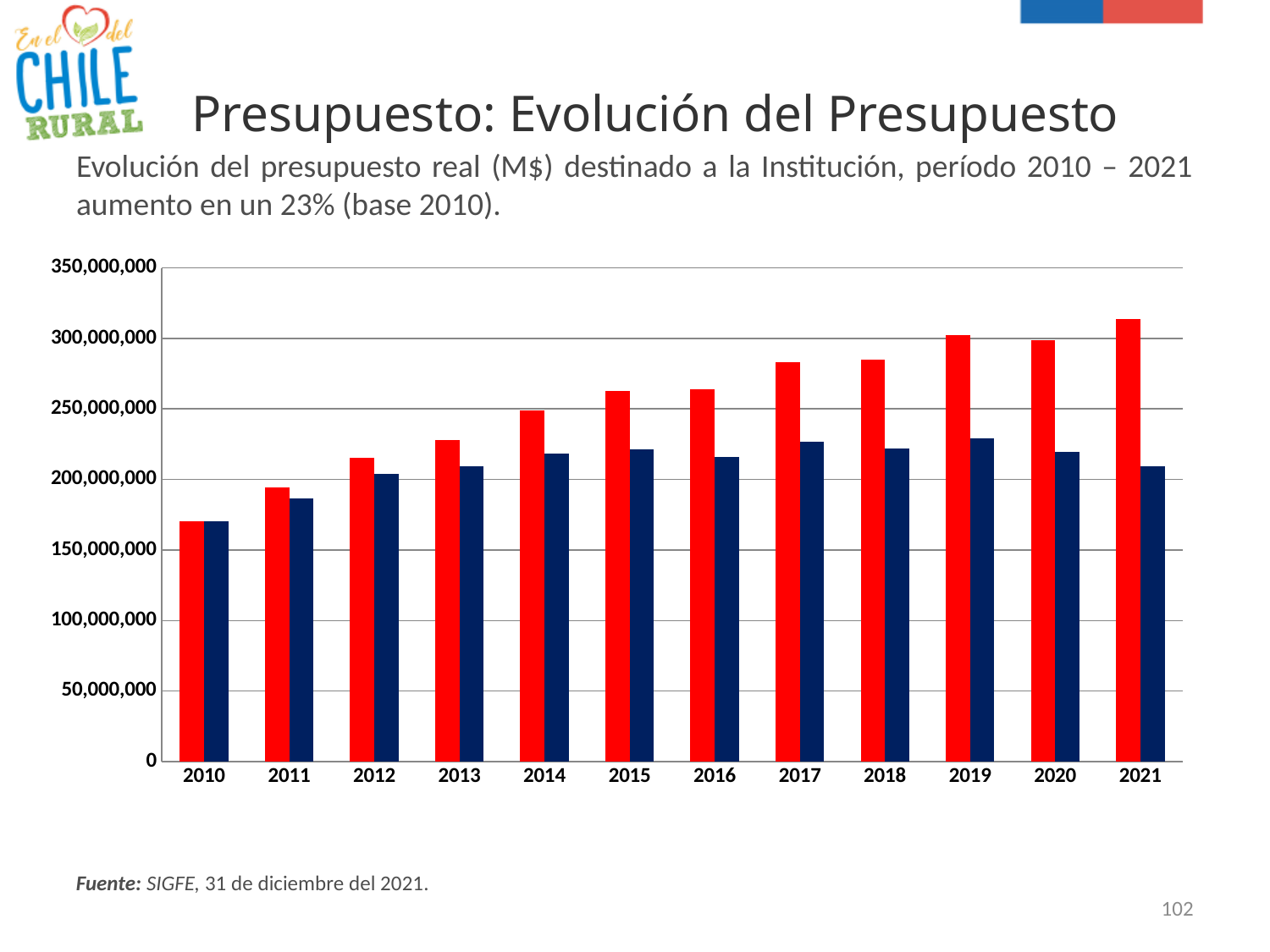
Which year has the tallest red bar? 2021 Is the value of the red bar for 2021 greater or less than 300,000,000? greater In 2021, which bar is taller, the red bar or the dark blue bar? the red bar Is the value of the red bar for 2010 greater or less than 200,000,000? less How many years are shown along the x axis of the chart? 12 Which year has the shortest dark blue bar? 2010 Which year has the shortest red bar? 2010 Do the red bars generally rise or fall from 2010 to 2021? rise What is the title of the slide containing the chart? Presupuesto: Evolución del Presupuesto Is the value of the red bar for 2017 greater or less than 250,000,000? greater What kind of chart is shown on the slide? bar chart